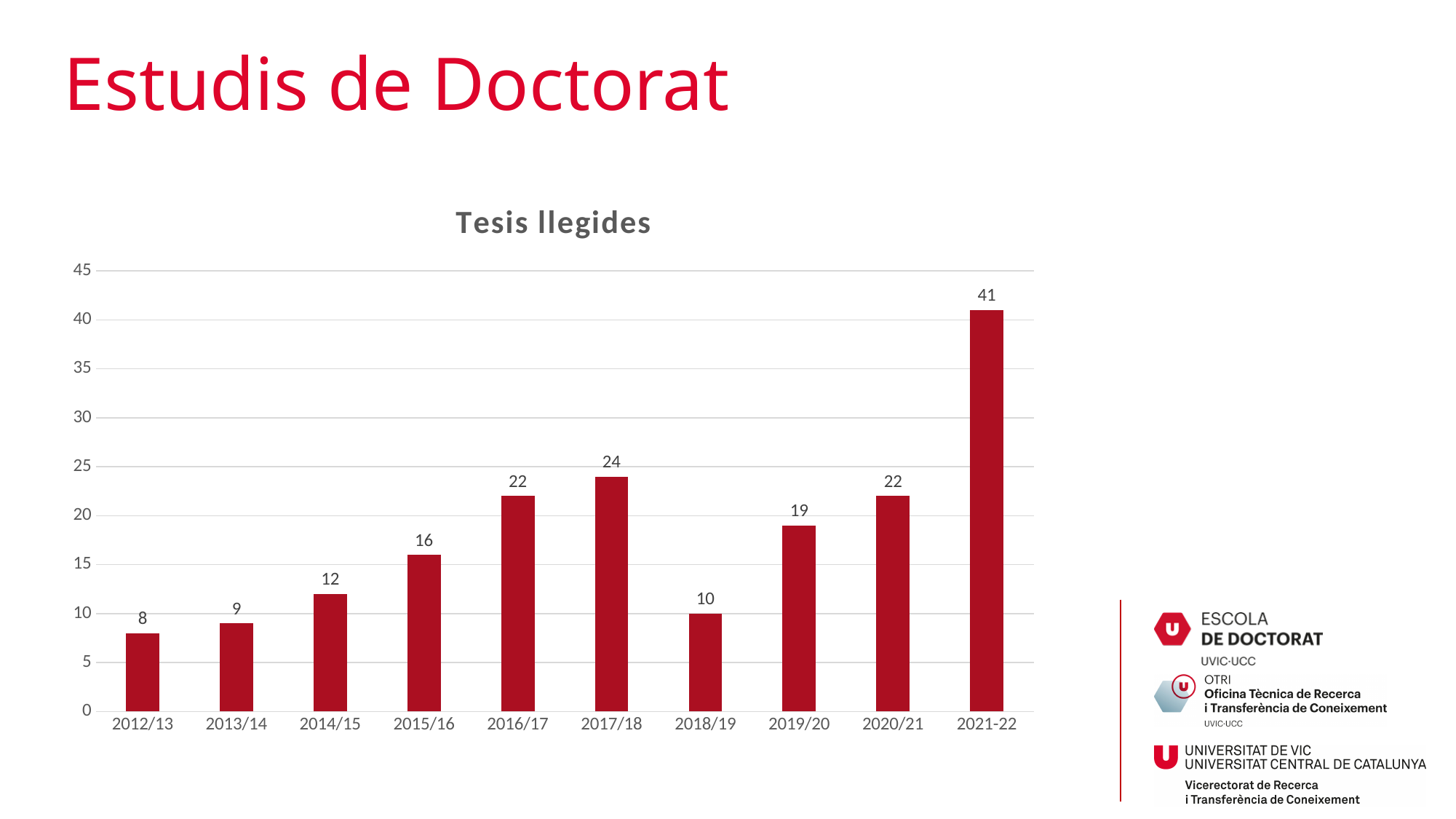
Which academic year has the lowest number of Tesis llegides? 2012/13 What is the difference between the values for 2014/15 and 2013/14? 3 Is the value for 2015/16 greater or less than 20? less Which academic year has the highest number of Tesis llegides? 2021-22 What is the value for 2016/17 in the Tesis llegides chart? 22 Which is larger, the value for 2017/18 or the value for 2019/20? 2017/18 What is the difference between the values for 2021-22 and 2020/21? 19 Do the values rise or fall from 2012/13 to 2017/18? rise How many academic years are shown on the x axis of the chart? 10 What kind of chart is shown on the slide? bar chart What is the title of the chart? Tesis llegides How many theses were read in 2018/19 according to the chart? 10